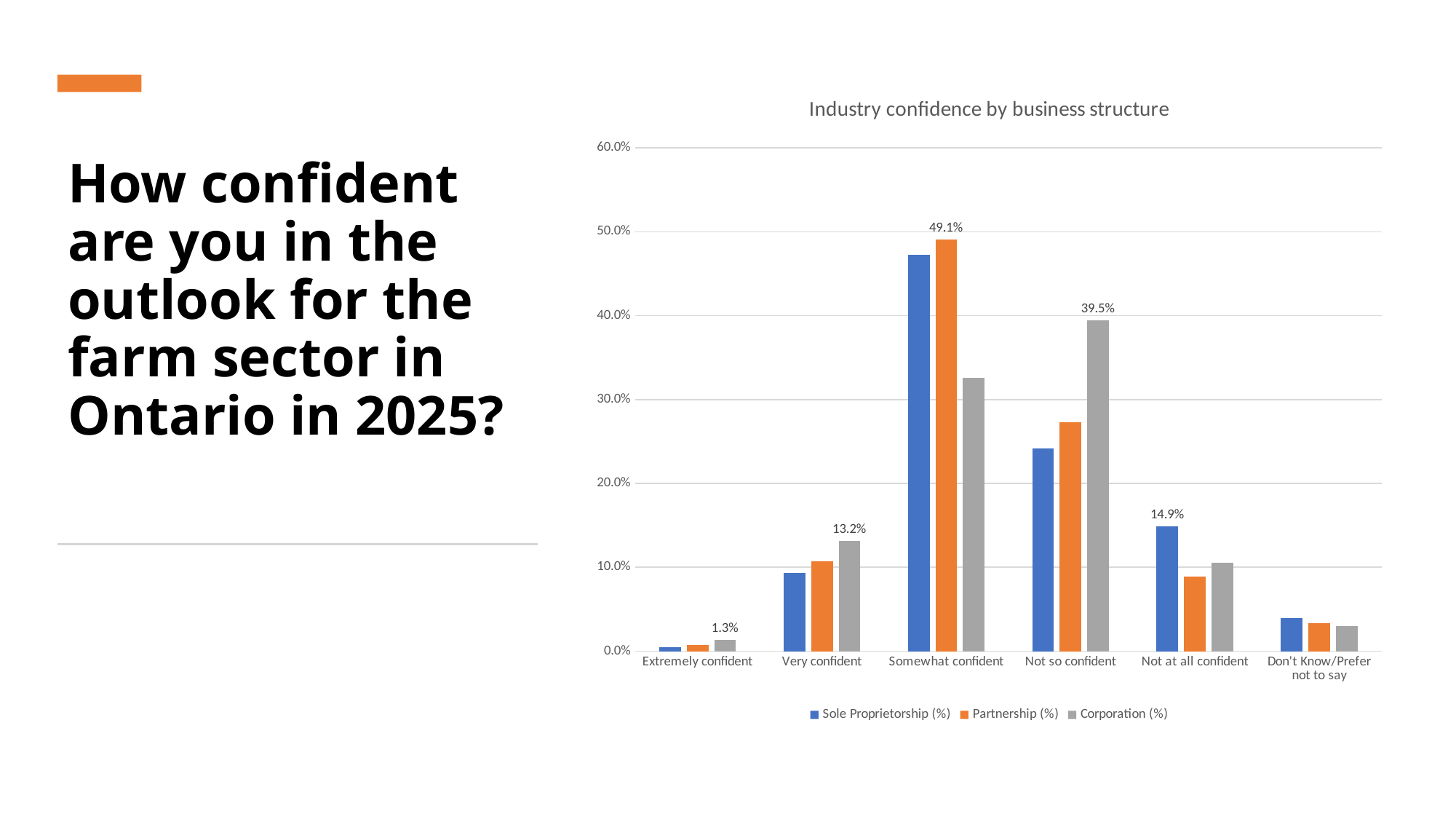
Which series has the highest value in the Not so confident category? Corporation (%) What is the value for Corporation (%) in the Extremely confident category? 1.3% What is the value for Sole Proprietorship (%) in the Not at all confident category? 14.9% How many confidence categories are shown on the x axis? 6 Which is larger in the Not at all confident category: Sole Proprietorship (%) or Partnership (%)? Sole Proprietorship (%) Is the value for Sole Proprietorship (%) in the Somewhat confident category greater or less than 40.0%? greater What is the value for Corporation (%) in the Very confident category? 13.2% What kind of chart is shown on the slide? Bar chart What is the value for Corporation (%) in the Not so confident category? 39.5% What is the value for Partnership (%) in the Somewhat confident category? 49.1% What is the title of the chart? Industry confidence by business structure How many series does the legend list? 3